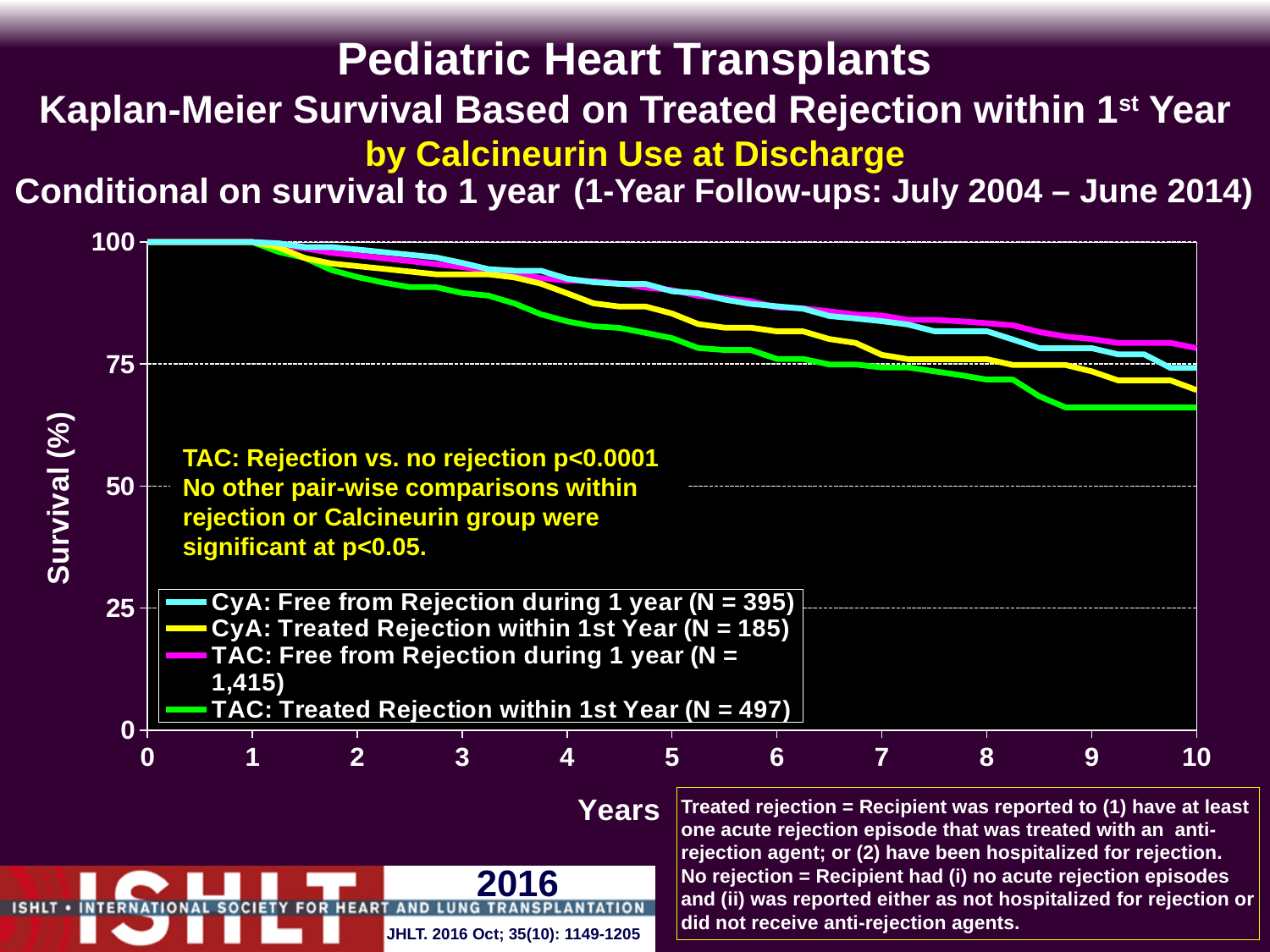
What kind of chart is shown on the slide? Line chart What is the N for the 'TAC: Free from Rejection during 1 year' group shown in the legend? N = 1,415 Is the survival value for the TAC: Treated Rejection within 1st Year group at year 10 greater or less than 75? less How many series does the legend list? 4 Is the survival value for the CyA: Treated Rejection within 1st Year group at year 10 greater or less than 75? less Which group has the lowest survival at year 10? TAC: Treated Rejection within 1st Year Is the survival value for the CyA: Free from Rejection during 1 year group at year 5 greater or less than 75? greater What is the N for the 'TAC: Treated Rejection within 1st Year' group shown in the legend? N = 497 What is the N for the 'CyA: Free from Rejection during 1 year' group shown in the legend? N = 395 What is the label of the y axis? Survival (%) What p-value is reported for the TAC rejection vs. no rejection comparison? p<0.0001 Do the survival curves rise or fall as years increase along the x axis? Fall